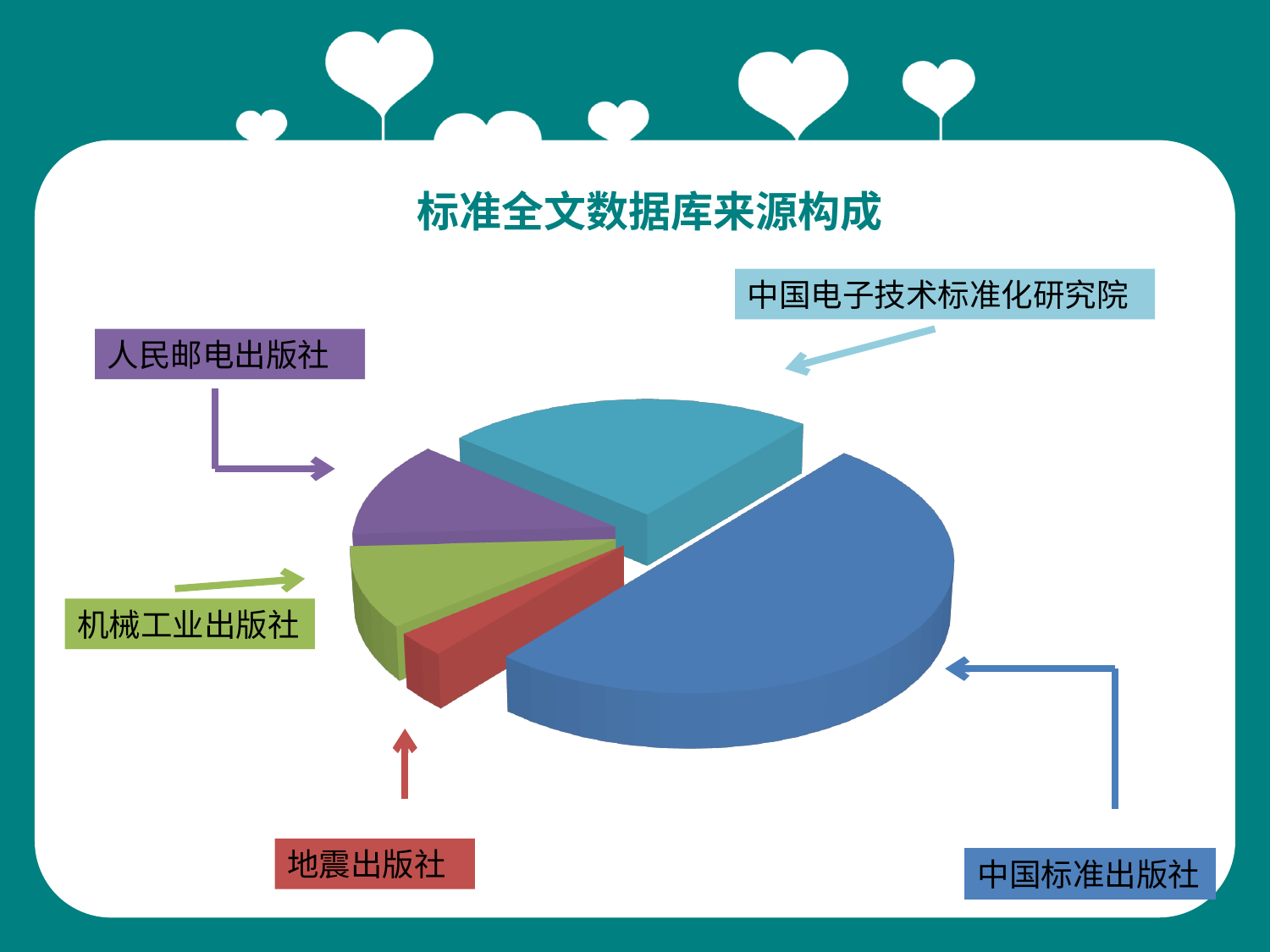
Which source has the largest slice of the pie? 中国标准出版社 Which slice is larger, 中国电子技术标准化研究院 or 地震出版社? 中国电子技术标准化研究院 What kind of chart is shown on the slide? pie chart Which slice is larger, 机械工业出版社 or 地震出版社? 机械工业出版社 What is the title of the chart? 标准全文数据库来源构成 What colour is the slice for 中国标准出版社? blue How many slices does the pie chart have? 5 Which source has the smallest slice of the pie? 地震出版社 Which slice is larger, 中国标准出版社 or 中国电子技术标准化研究院? 中国标准出版社